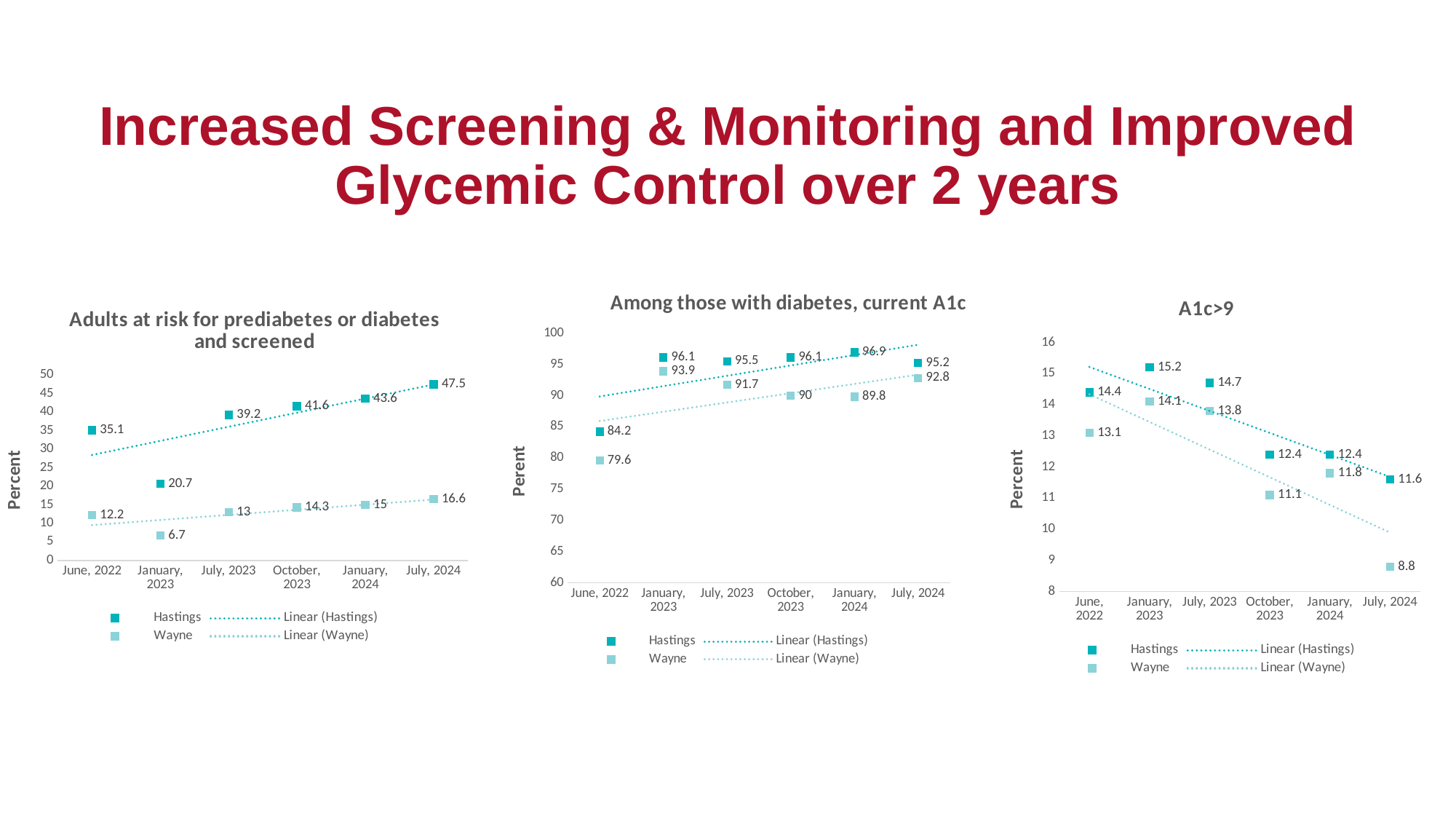
In the 'Adults at risk for prediabetes or diabetes and screened' chart, what is the Wayne value for January, 2023? 6.7 In the 'Among those with diabetes, current A1c' chart, which time point has the highest Hastings value? January, 2024 In the 'A1c>9' chart, which is larger for October, 2023: the Hastings value or the Wayne value? Hastings In the 'Among those with diabetes, current A1c' chart, what is the difference between the Hastings values for June, 2022 and January, 2023? 11.9 In the 'Adults at risk for prediabetes or diabetes and screened' chart, what is the Hastings value for July, 2024? 47.5 How many time points are plotted on the x axis of the 'A1c>9' chart? 6 In the 'Adults at risk for prediabetes or diabetes and screened' chart, which time point has the lowest Hastings value? January, 2023 In the 'A1c>9' chart, what is the Wayne value for July, 2024? 8.8 In the 'Among those with diabetes, current A1c' chart, what is the Wayne value for June, 2022? 79.6 In the 'A1c>9' chart, do the Hastings values generally rise or fall from June, 2022 to July, 2024? fall In the 'A1c>9' chart, which time point has the highest Hastings value? January, 2023 In the 'Adults at risk for prediabetes or diabetes and screened' chart, what is the difference between the Hastings and Wayne values for July, 2024? 30.9